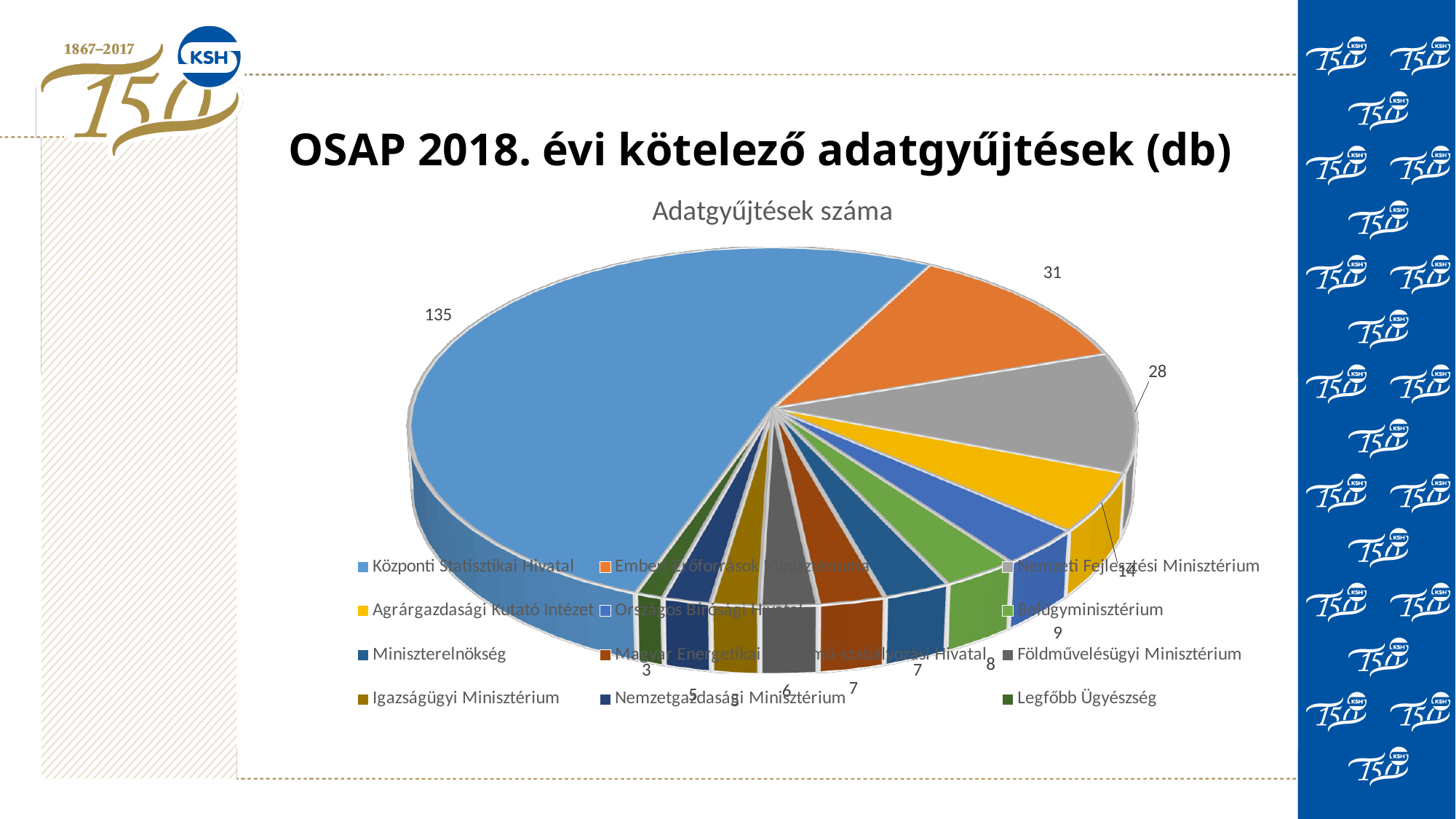
Which category has the smallest slice of the pie? Legfőbb Ügyészség What is the value for Nemzeti Fejlesztési Minisztérium? 28 What is the value for Agrárgazdasági Kutató Intézet? 14 What is the difference between the values for Emberi Erőforrások Minisztériuma and Agrárgazdasági Kutató Intézet? 17 What is the title of the chart? Adatgyűjtések száma How many categories does the legend of the pie chart list? 12 What type of chart is shown on the slide? pie chart What is the difference between the values for Központi Statisztikai Hivatal and Emberi Erőforrások Minisztériuma? 104 What is the value for Központi Statisztikai Hivatal? 135 Which is larger, the value for Emberi Erőforrások Minisztériuma or the value for Nemzeti Fejlesztési Minisztérium? Emberi Erőforrások Minisztériuma What is the value for Emberi Erőforrások Minisztériuma? 31 Which category has the largest slice of the pie? Központi Statisztikai Hivatal